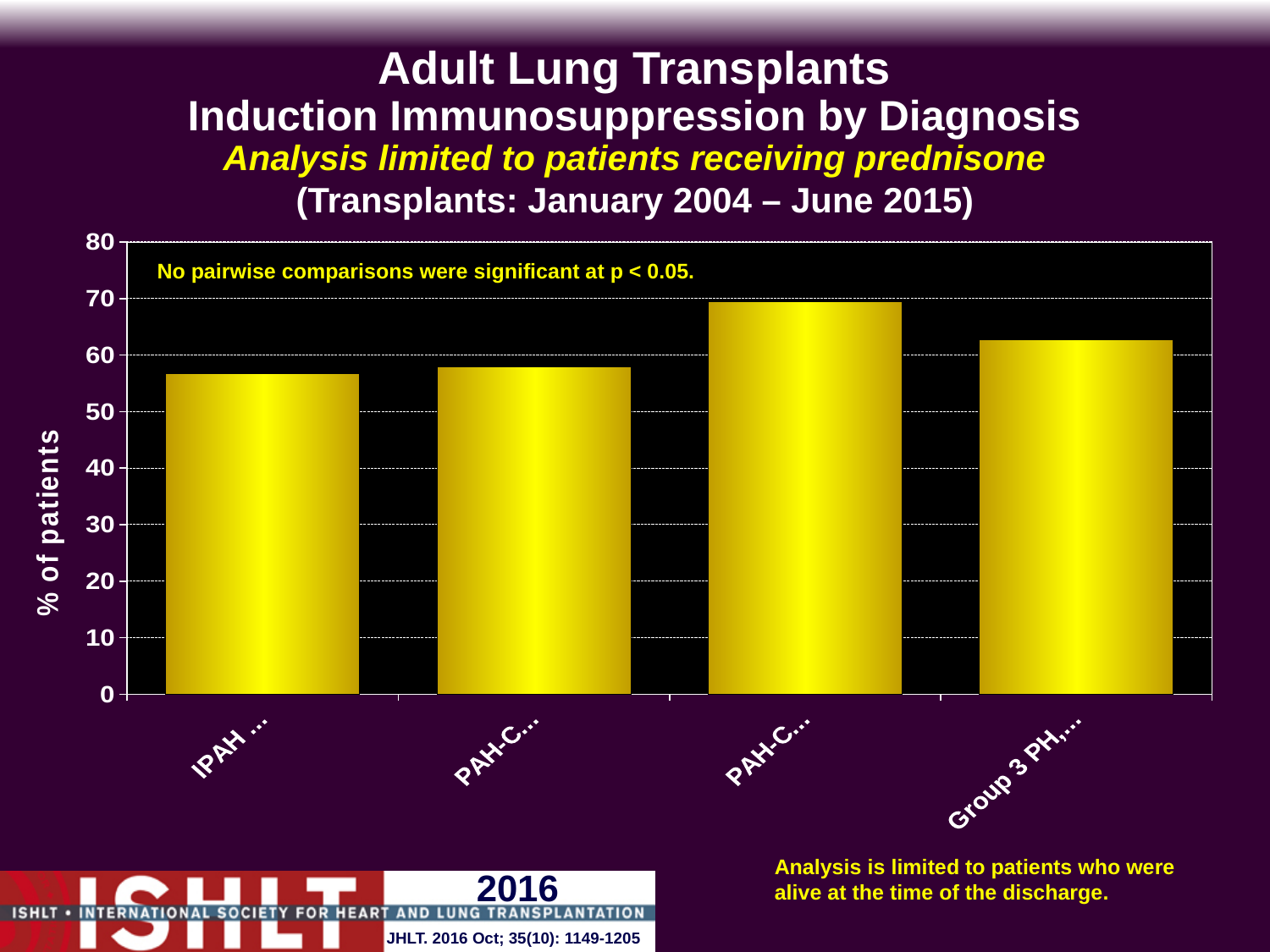
Which bar is the highest in the chart? the third bar from the left (PAH-C...) Is the value for the third bar from the left greater or less than 60? greater What is the label of the y-axis? % of patients How many bars (diagnosis categories) are plotted in the chart? 4 Which is larger, the value for the third bar from the left or the value for the rightmost bar (Group 3 PH)? the third bar from the left What kind of chart is shown on the slide? bar chart Which is larger, the value for the first bar (IPAH) or the value for the third bar from the left? the third bar from the left Is the value for the rightmost bar (Group 3 PH) greater or less than 60? greater What note is printed inside the plot area at the top of the chart? No pairwise comparisons were significant at p < 0.05. Is the value for the second bar from the left greater or less than 60? less